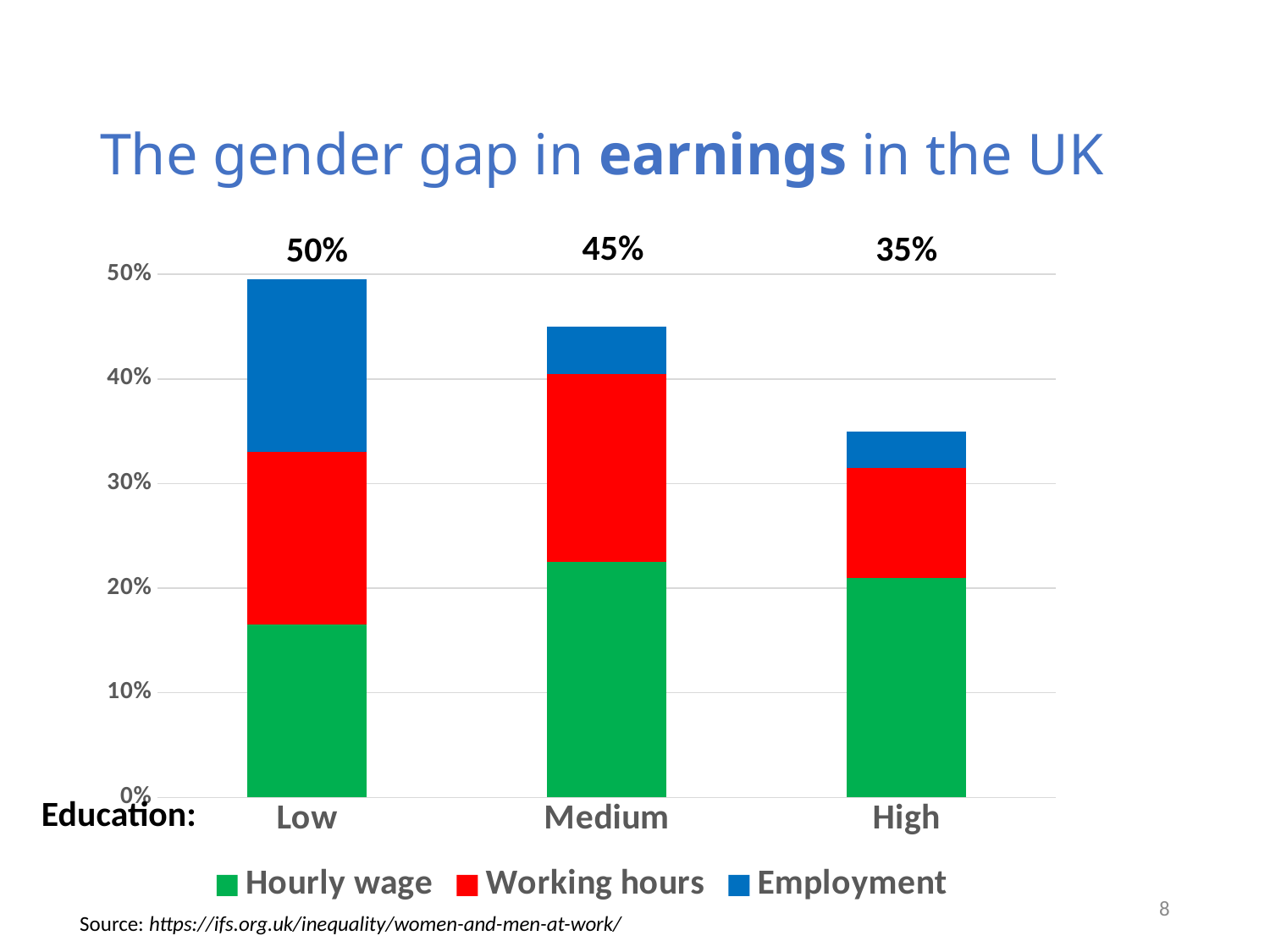
Which education group has the largest total gender gap in earnings? Low Does the total gender gap in earnings rise or fall as education level goes from Low to High? Fall What kind of chart is shown on the slide? Stacked bar chart Which education group has the smallest total gender gap in earnings? High Is the Hourly wage component for the Low education group greater or less than 20%? less How many education groups are shown on the x axis? 3 What is the total gender gap in earnings for the Medium education group? 45% What is the total gender gap in earnings for the Low education group? 50% How many series does the legend list? 3 What is the total gender gap in earnings for the High education group? 35% Is the total gap larger for the Medium group or the High group? Medium What is the difference between the total gap for the Low group and the total gap for the High group? 15%